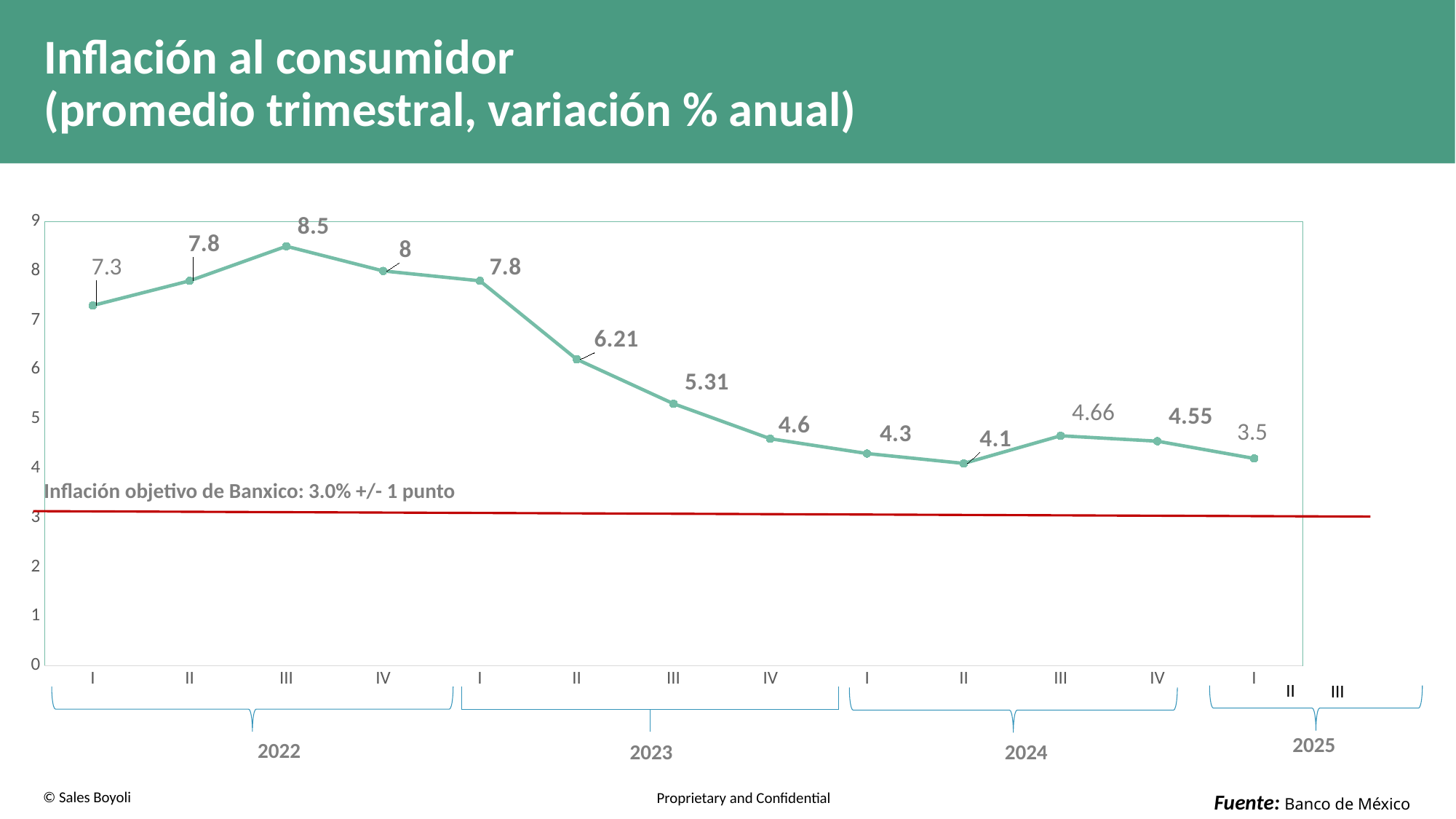
How many data points are plotted on the line? 13 What is the inflation value for quarter III of 2022? 8.5 Which quarter of 2024 has the lowest inflation value? II Does the inflation value generally rise or fall from quarter I of 2023 to quarter IV of 2023? fall What is the inflation value for quarter IV of 2024? 4.55 What type of chart is shown on the slide? line chart Is the inflation value for quarter III of 2023 greater or less than 5? greater What is the inflation value for quarter II of 2023? 6.21 Which is larger, the inflation value for quarter III of 2024 or quarter IV of 2024? III 2024 What does the red horizontal line represent according to the text on the chart? Inflación objetivo de Banxico: 3.0% +/- 1 punto Which quarter has the highest inflation value? III 2022 What is the difference between the inflation value for quarter I of 2023 and quarter II of 2023? 1.59